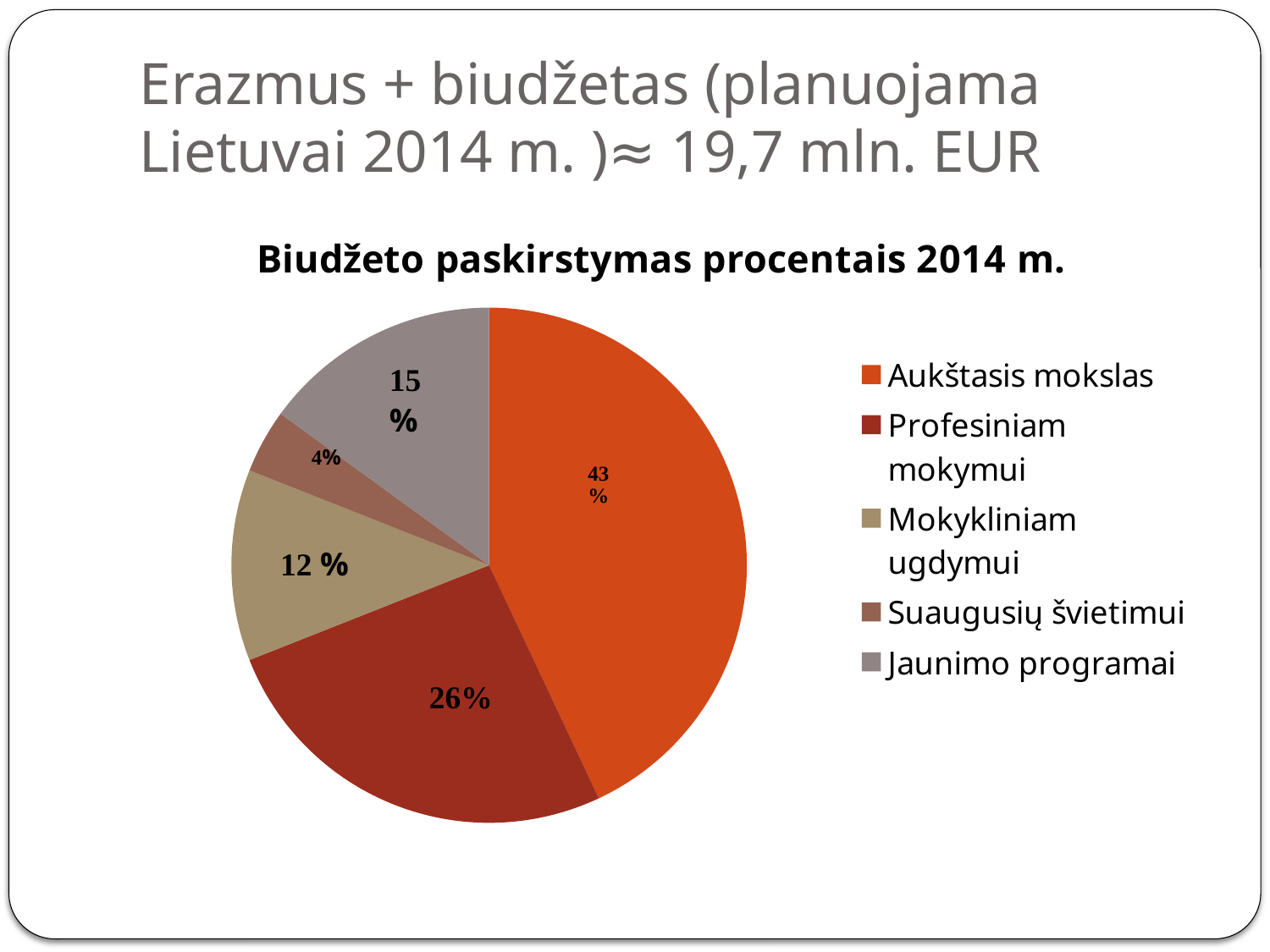
What percentage of the budget goes to Suaugusių švietimui? 4% Which category receives the largest share of the budget? Aukštasis mokslas What percentage of the budget goes to Profesiniam mokymui? 26% How many categories does the pie chart show? 5 What percentage of the budget goes to Mokykliniam ugdymui? 12% What percentage of the budget goes to Aukštasis mokslas? 43% Which receives a larger share, Jaunimo programai or Mokykliniam ugdymui? Jaunimo programai What is the difference in percentage points between Aukštasis mokslas and Profesiniam mokymui? 17 What type of chart is shown on the slide? Pie chart What percentage of the budget goes to Jaunimo programai? 15% What is the title of the chart? Biudžeto paskirstymas procentais 2014 m. Which category receives the smallest share of the budget? Suaugusių švietimui